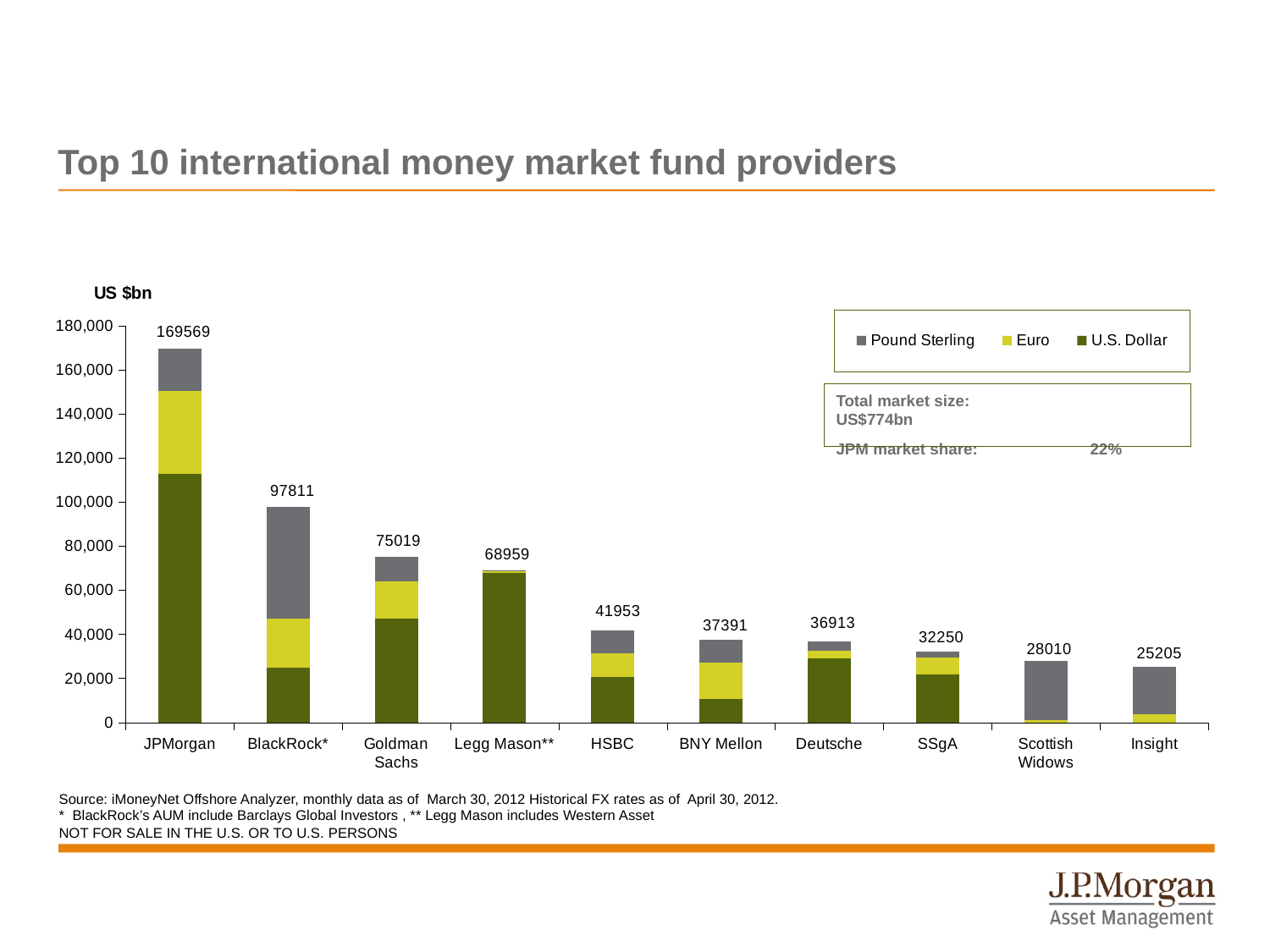
What is the difference between the totals for Goldman Sachs and Legg Mason**? 6060 What kind of chart is shown? Stacked bar chart How many providers are shown on the x axis? 10 Which provider has the highest total value? JPMorgan How many series does the legend list? 3 Which provider has the lowest total value? Insight What is the total value shown for JPMorgan? 169569 What is the total value shown for Scottish Widows? 28010 Which has a larger total, HSBC or SSgA? HSBC Is the U.S. Dollar segment for JPMorgan greater or less than 100,000? greater What is the total value shown for Goldman Sachs? 75019 What is the difference between the totals for JPMorgan and BlackRock*? 71758